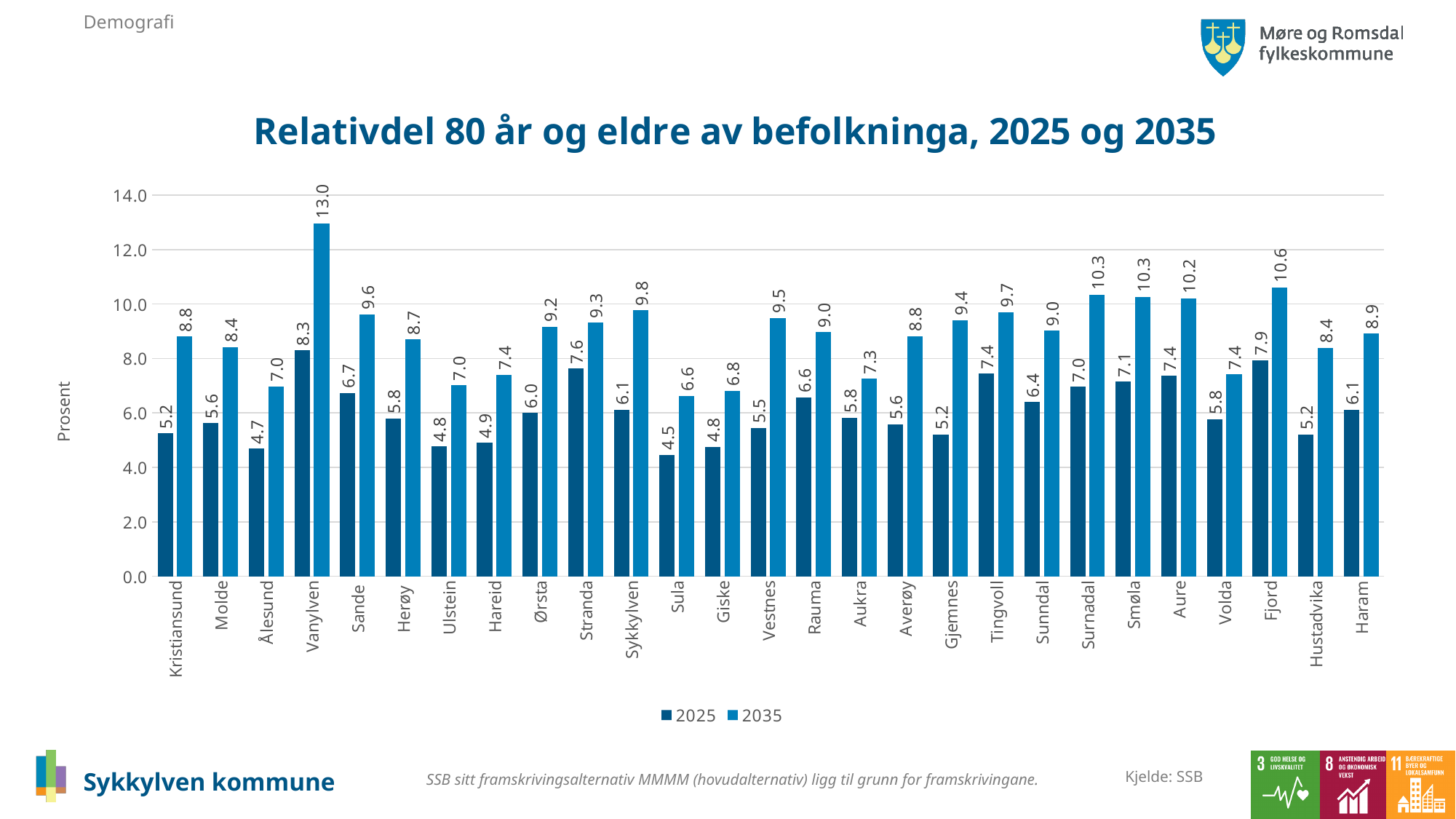
Which is larger, the 2035 value for Molde or the 2035 value for Kristiansund? Kristiansund What is the difference between the 2035 and 2025 values for Sykkylven? 3.7 What is the label on the y axis? Prosent How many series does the legend list? 2 Which municipality has the highest 2035 value? Vanylven What is the 2035 value for Sykkylven? 9.8 Which municipality has the lowest 2025 value? Sula What kind of chart is shown on the slide? bar chart What is the 2025 value for Vanylven? 8.3 How many municipalities are shown on the x axis? 27 Is the 2035 value for Vanylven greater or less than 12.0? greater What is the 2035 value for Fjord? 10.6